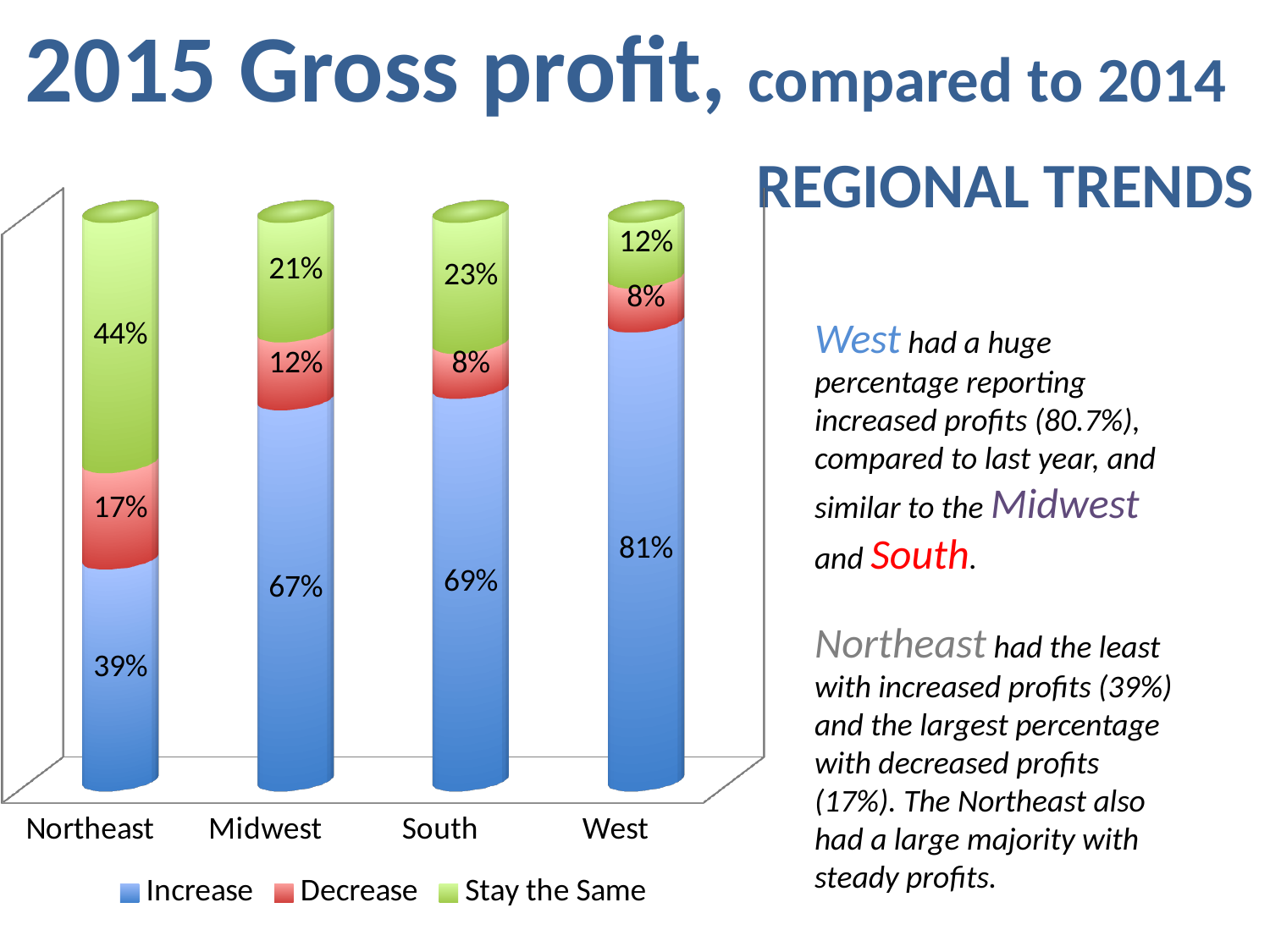
What is the Stay the Same value for the South? 23% Which region has the lowest Increase value? Northeast How many regions are shown on the x axis? 4 Which is larger, the Decrease value for the Northeast or the Decrease value for the South? Northeast What is the Decrease value for the Midwest? 12% What is the difference between the Increase values for the West and the Northeast? 42 percentage points What percentage of the Northeast reported an increase in gross profit? 39% What is the Increase value for the West? 81% How many series does the legend list? 3 Which region has the highest Stay the Same value? Northeast Which region has the highest Increase value? West What kind of chart is shown on the slide? Stacked bar chart